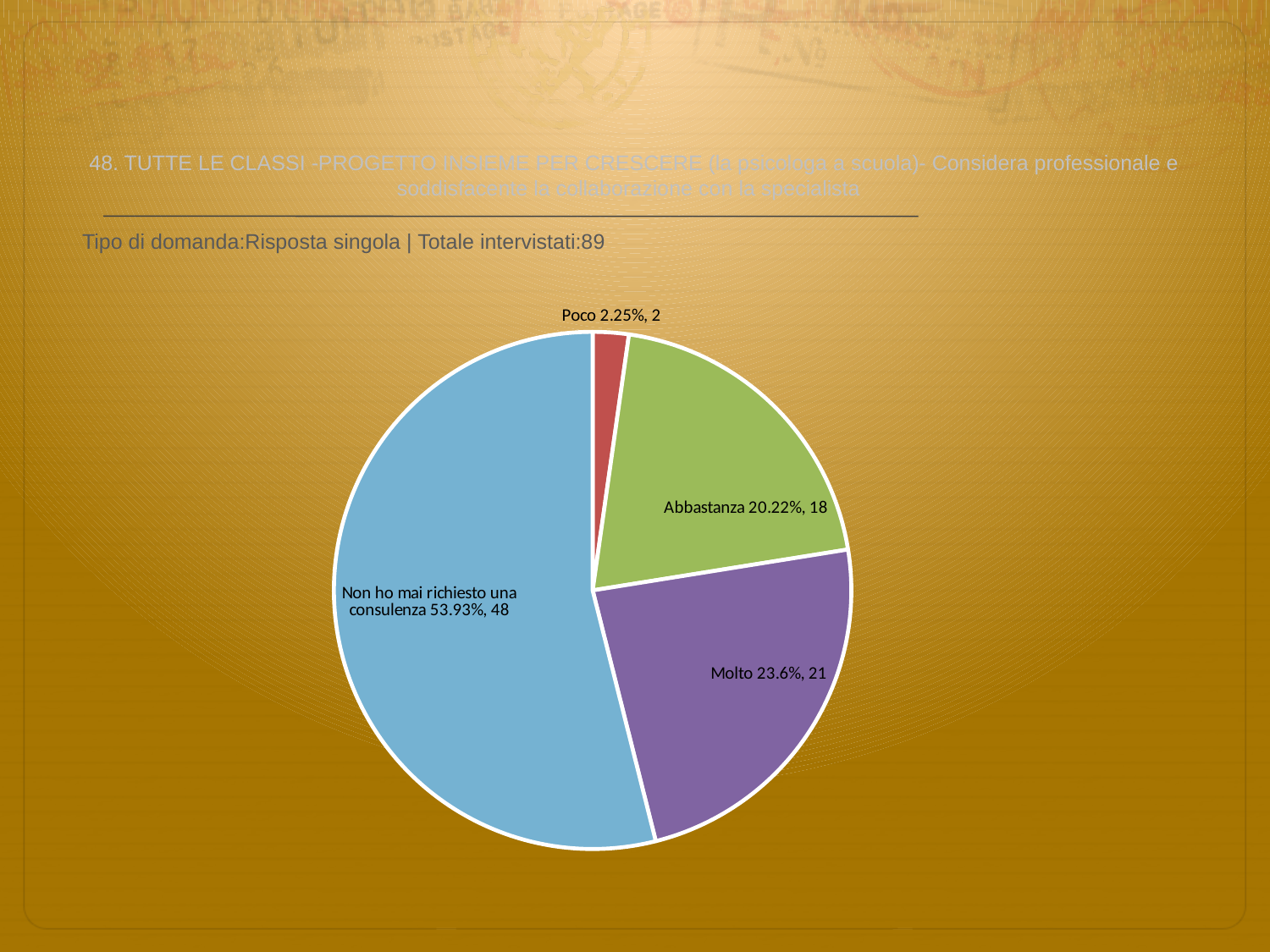
How many respondents answered 'Poco'? 2 What is the difference in respondent count between 'Molto' and 'Abbastanza'? 3 What percentage share does the 'Non ho mai richiesto una consulenza' slice have? 53.93% What percentage share does the 'Abbastanza' slice have? 20.22% Which has more respondents, 'Molto' or 'Abbastanza'? Molto Which category has the smallest slice of the pie? Poco What is the total number of respondents shown in the subtitle? 89 How many slices does the pie chart have? 4 What kind of chart is shown on the slide? pie chart What colour is the 'Molto' slice? purple Which category has the largest slice of the pie? Non ho mai richiesto una consulenza How many respondents answered 'Molto'? 21